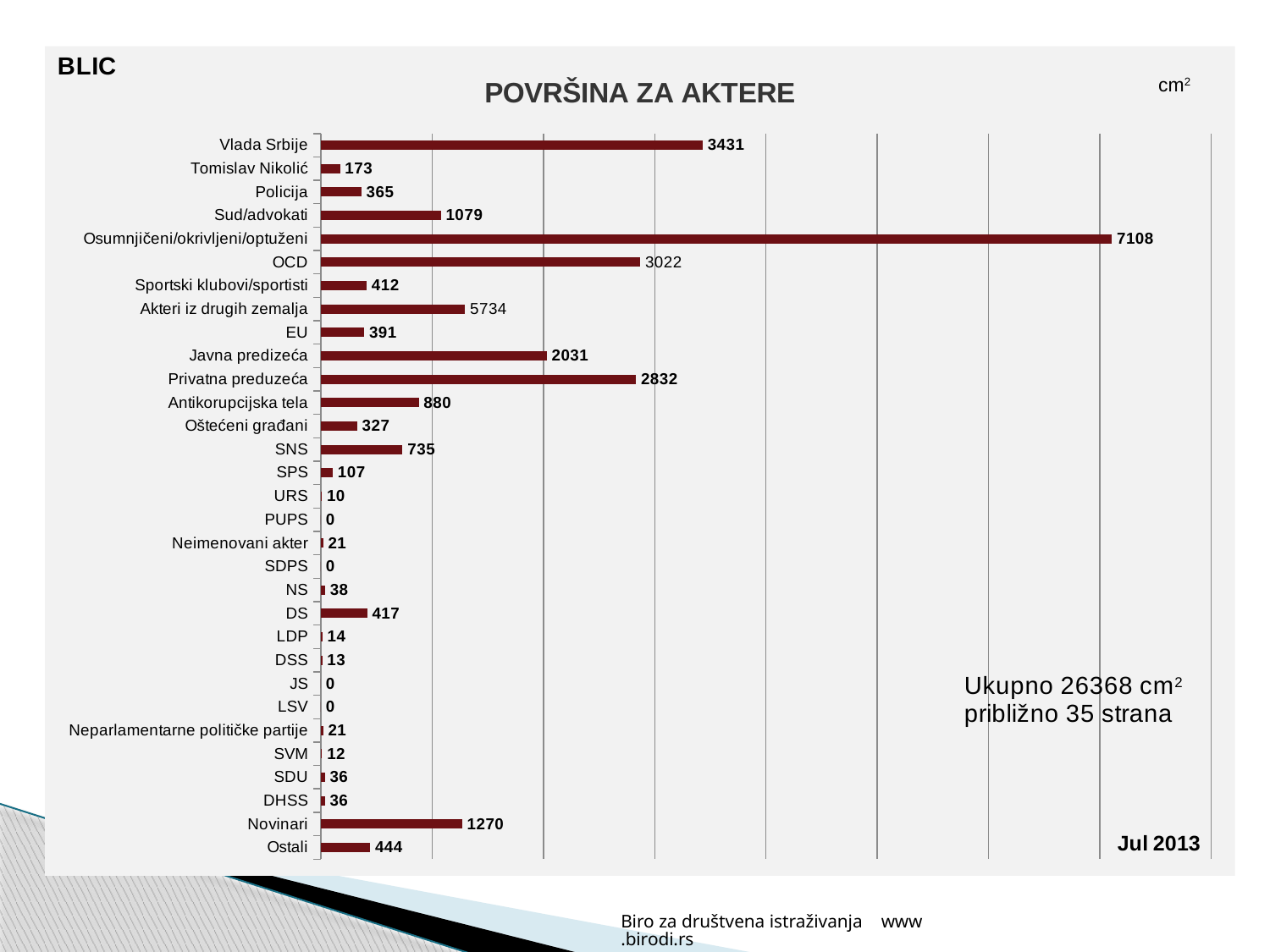
Which is larger, the value for SNS or the value for DS? SNS What is the value for Vlada Srbije? 3431 What is the value for Novinari? 1270 Which is larger, the value for Policija or the value for EU? EU What is the value for Antikorupcijska tela? 880 What kind of chart is shown on the slide? bar chart What is the title of the chart? POVRŠINA ZA AKTERE What is the difference between the values for Vlada Srbije and OCD? 409 How many categories are shown on the chart? 31 What is the value for SNS? 735 Which category has the highest value? Osumnjičeni/okrivljeni/optuženi What is the difference between the values for Privatna preduzeća and Javna predizeća? 801